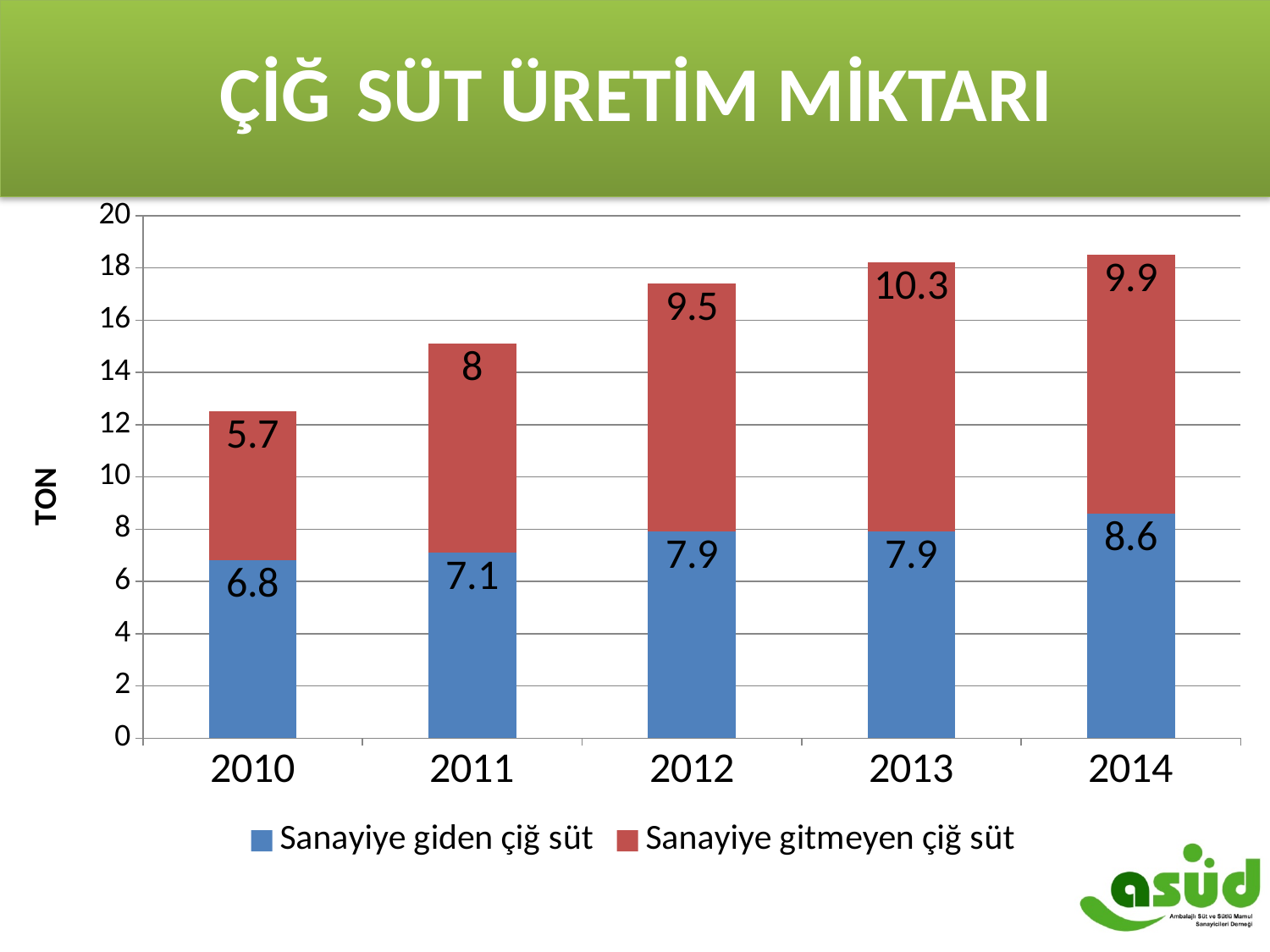
What is the value for "Sanayiye giden çiğ süt" in 2010? 6.8 What is the total of the stacked bar for 2010? 12.5 In which year is the value for "Sanayiye gitmeyen çiğ süt" highest? 2013 What is the value for "Sanayiye gitmeyen çiğ süt" in 2013? 10.3 What is the value for "Sanayiye giden çiğ süt" in 2014? 8.6 Which is larger in 2011: "Sanayiye giden çiğ süt" or "Sanayiye gitmeyen çiğ süt"? Sanayiye gitmeyen çiğ süt How many series does the legend list? 2 What kind of chart is shown on the slide? Stacked bar chart In which year is the value for "Sanayiye giden çiğ süt" lowest? 2010 What is the total of the stacked bar for 2014? 18.5 How many years are shown on the x axis? 5 What is the difference between the "Sanayiye gitmeyen çiğ süt" values for 2012 and 2010? 3.8